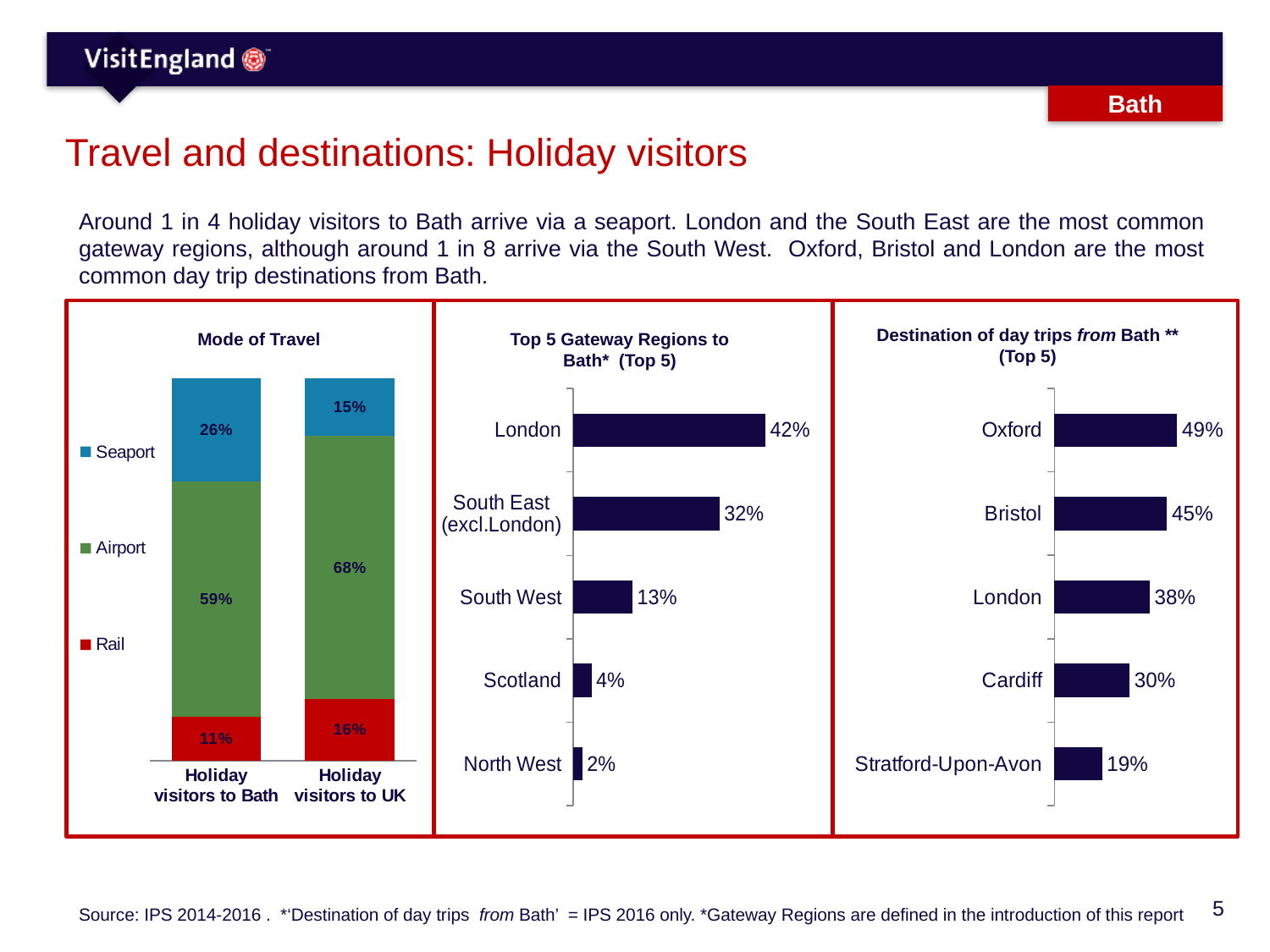
What kind of chart is the 'Top 5 Gateway Regions to Bath' chart? Bar chart In the 'Mode of Travel' chart, which is larger: the seaport share for holiday visitors to Bath or for holiday visitors to UK? Holiday visitors to Bath In the 'Top 5 Gateway Regions to Bath' chart, what is the difference between London and South East (excl.London)? 10% In the 'Top 5 Gateway Regions to Bath' chart, what is the value for South West? 13% In the 'Mode of Travel' chart, what percentage of holiday visitors to UK arrive by airport? 68% In the 'Top 5 Gateway Regions to Bath' chart, which region has the lowest value? North West In the 'Destination of day trips from Bath' chart, what is the value for Cardiff? 30% In the 'Mode of Travel' chart, what is the difference between the rail share for holiday visitors to UK and holiday visitors to Bath? 5% In the 'Mode of Travel' chart, how many series does the legend list? 3 How many destinations are shown in the 'Destination of day trips from Bath' chart? 5 In the 'Mode of Travel' chart, what percentage of holiday visitors to Bath arrive by seaport? 26% In the 'Destination of day trips from Bath' chart, which destination has the highest value? Oxford